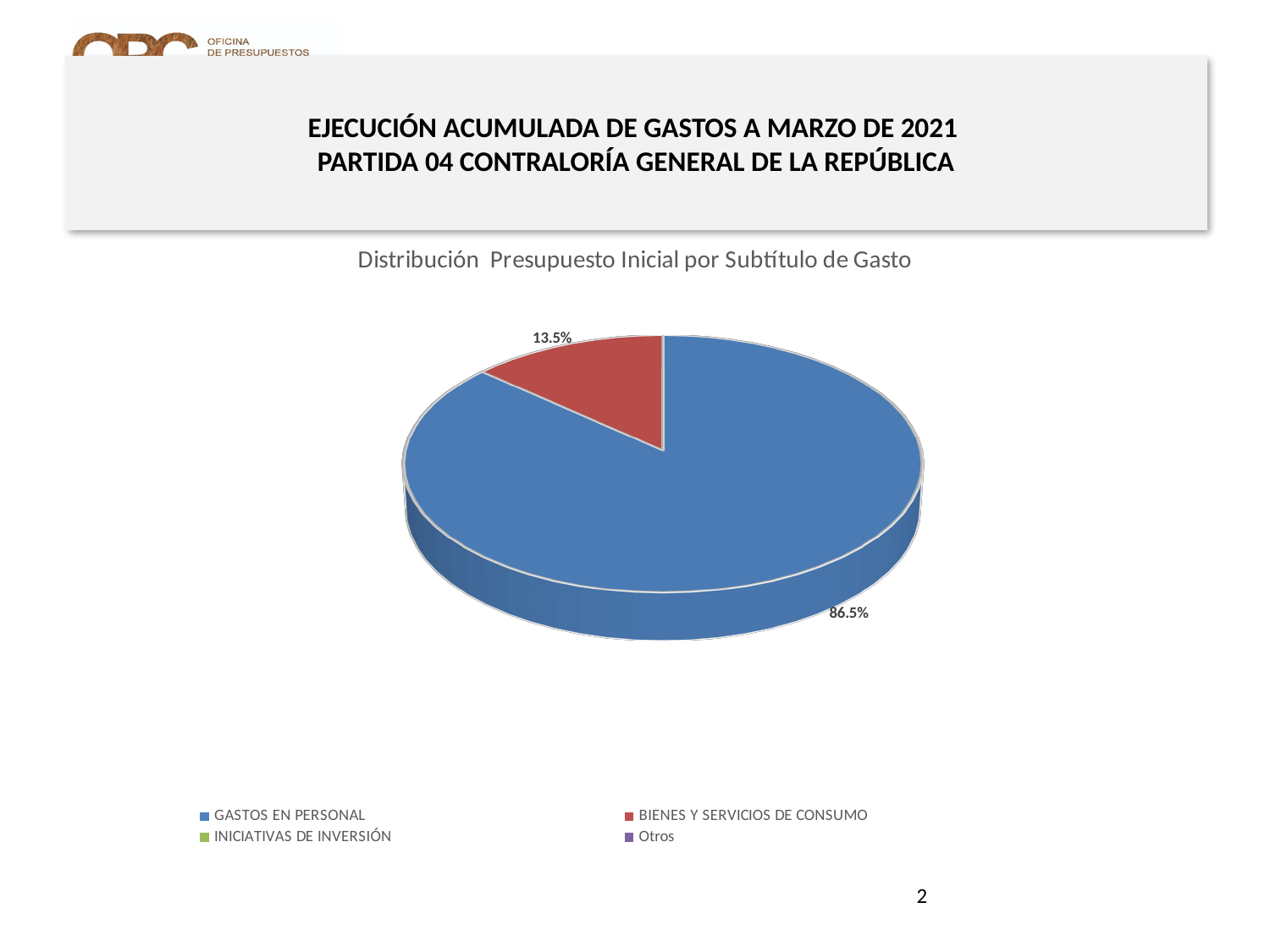
Which of the labelled slices is the smallest? BIENES Y SERVICIOS DE CONSUMO What colour is the slice for BIENES Y SERVICIOS DE CONSUMO? Red What share of the pie does BIENES Y SERVICIOS DE CONSUMO represent? 13.5% What is the title of the chart? Distribución Presupuesto Inicial por Subtítulo de Gasto By how many percentage points does GASTOS EN PERSONAL exceed BIENES Y SERVICIOS DE CONSUMO? 73.0 percentage points What kind of chart is shown on the slide? Pie chart Which category has the largest slice of the pie? GASTOS EN PERSONAL How many entries does the chart legend list? 4 Which is larger, the slice for GASTOS EN PERSONAL or the slice for BIENES Y SERVICIOS DE CONSUMO? GASTOS EN PERSONAL How many slices have a percentage label printed on the pie? 2 What share of the pie does GASTOS EN PERSONAL represent? 86.5%